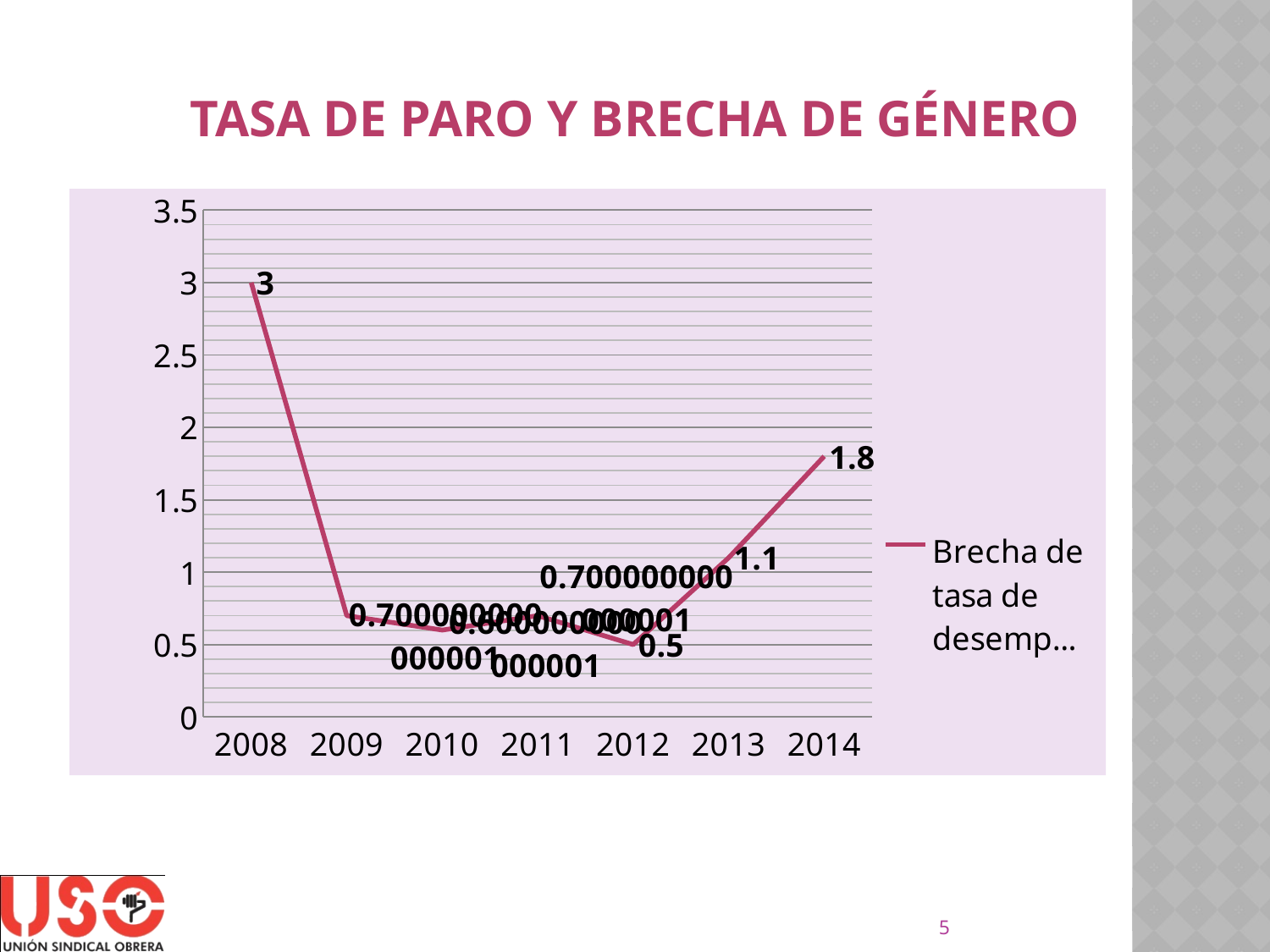
Do the values rise or fall from 2012 to 2014? rise What kind of chart is shown? line chart Which is larger, the value for 2013 or the value for 2014? 2014 What is the value for 2012? 0.5 What is the difference between the values for 2014 and 2013? 0.7 What is the difference between the values for 2008 and 2014? 1.2 What is the value for 2014? 1.8 How many years are shown on the x axis? 7 What is the value for 2013? 1.1 Is the value for 2009 greater or less than 1? less What is the value for 2008? 3 Which year has the highest value? 2008